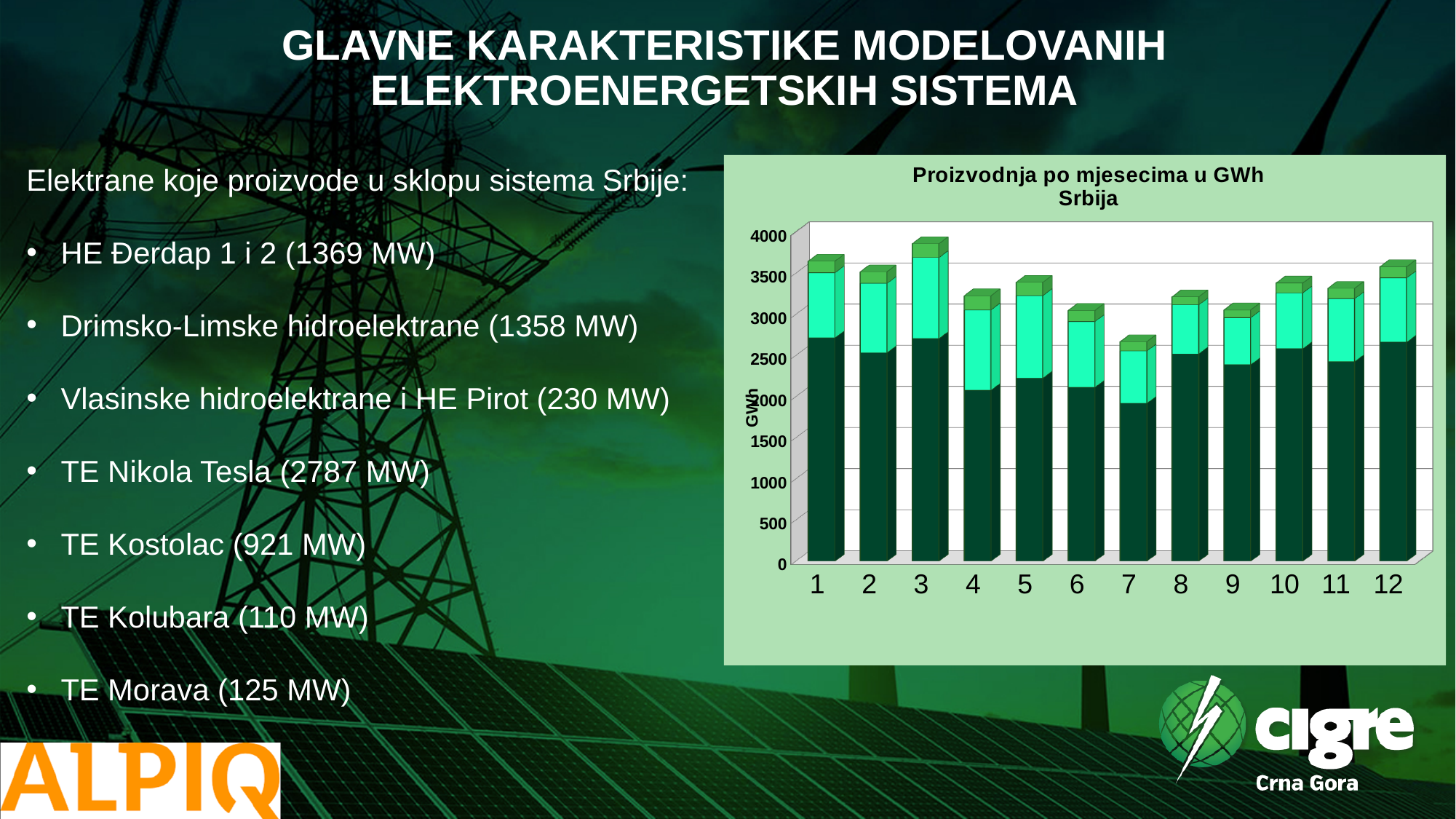
What is the label on the vertical axis of the chart? GWh Is the total value for month 3 greater or less than 3500? greater Which month has the highest total bar in the chart? 3 How many months (categories) are shown on the x axis of the chart? 12 Which month has a larger total bar, month 1 or month 4? 1 What kind of chart is shown on the slide? bar chart What is the title of the chart? Proizvodnja po mjesecima u GWh Srbija Is the total value for month 7 greater or less than 3000? less Is the total value for month 8 greater or less than 3000? greater Which month has the lowest total bar in the chart? 7 Which month has a larger total bar, month 7 or month 10? 10